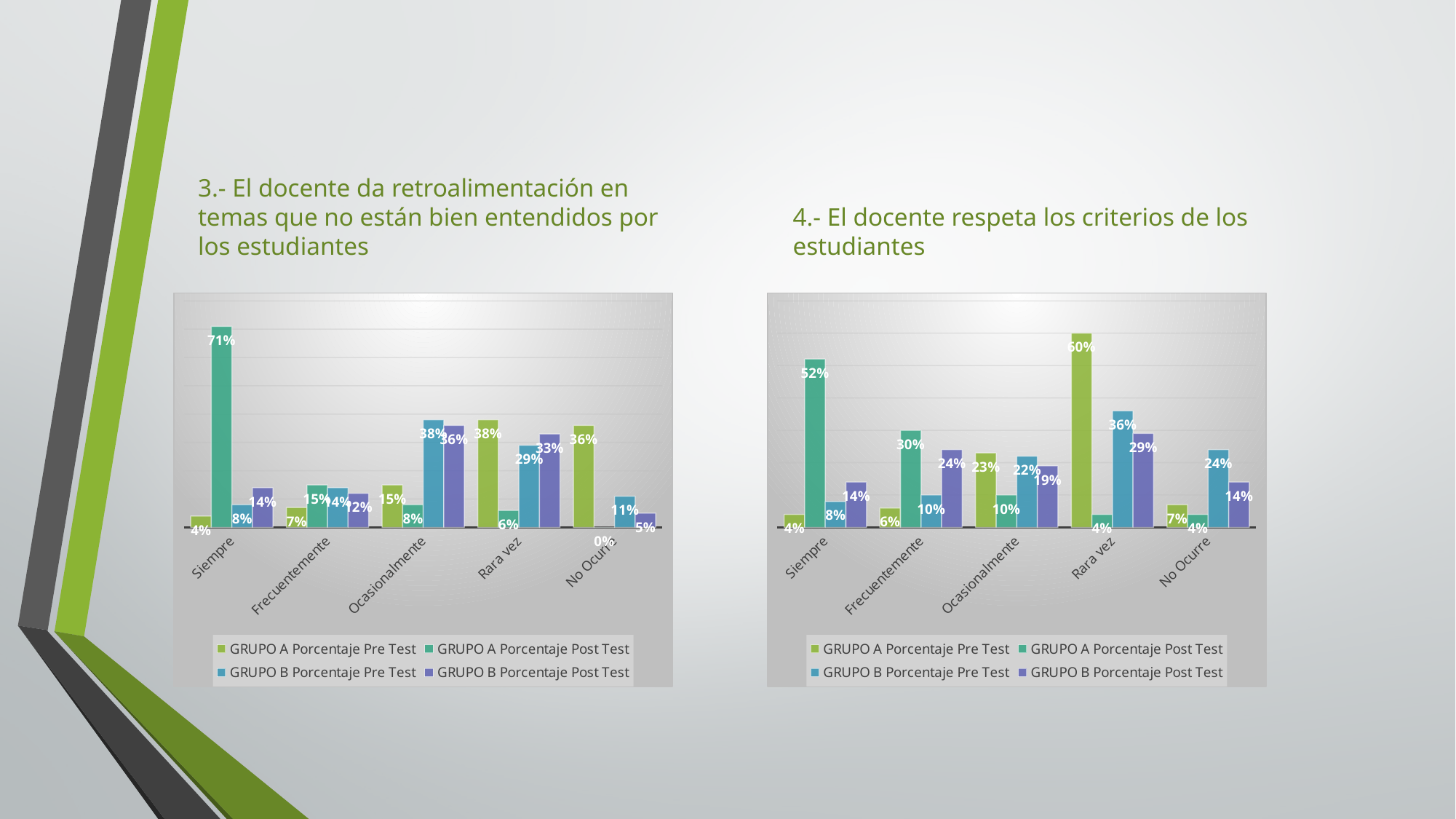
In the left chart (question 3), what is the difference between the GRUPO A Porcentaje Post Test and GRUPO A Porcentaje Pre Test values for Siempre? 67% In the left chart (question 3), which category has the highest GRUPO A Porcentaje Pre Test value? Rara vez In the left chart (question 3), what is the GRUPO A Porcentaje Post Test value for Siempre? 71% In the right chart (question 4), which category has the lowest GRUPO A Porcentaje Post Test value? Rara vez and No Ocurre (both 4%) In the right chart (question 4), what is the GRUPO B Porcentaje Post Test value for Frecuentemente? 24% How many series does the legend of the right chart (question 4) list? 4 In the right chart (question 4), which is larger for Ocasionalmente: GRUPO A Porcentaje Pre Test or GRUPO B Porcentaje Post Test? GRUPO A Porcentaje Pre Test What kind of chart is the left chart (question 3)? Bar chart In the right chart (question 4), what is the difference between the GRUPO B Porcentaje Pre Test and GRUPO B Porcentaje Post Test values for No Ocurre? 10% In the right chart (question 4), what is the GRUPO A Porcentaje Pre Test value for Rara vez? 60% In the left chart (question 3), what is the GRUPO A Porcentaje Post Test value for No Ocurre? 0% In the left chart (question 3), what is the GRUPO B Porcentaje Pre Test value for Ocasionalmente? 38%